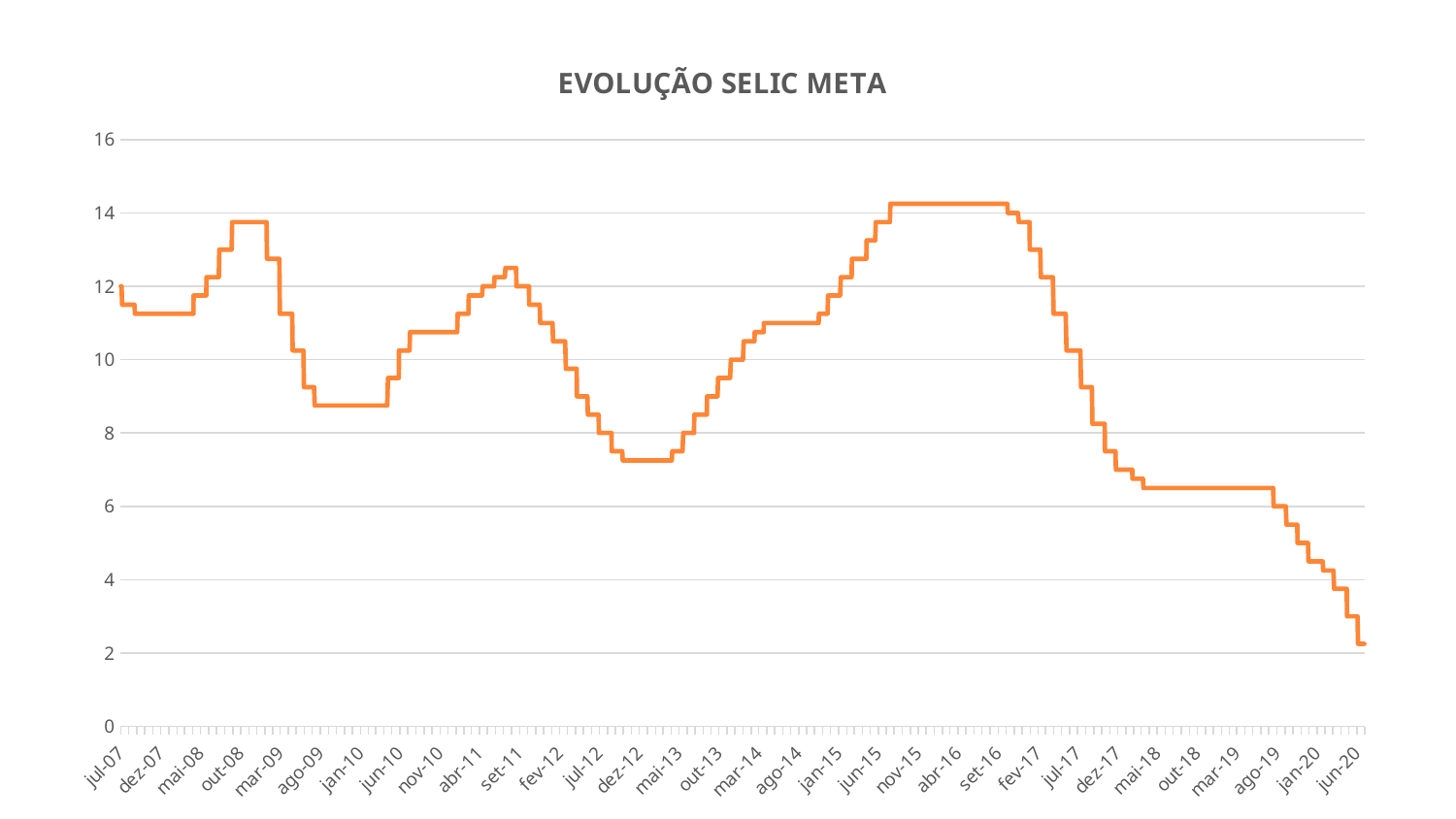
At which x-axis label does the line reach its lowest value? jun-20 Is the value for nov-15 greater or less than 12? greater Does the line rise or fall between set-16 and jun-20? Fall Is the value for jan-10 greater or less than 10? less Is the value for mar-18 greater or less than 8? less What is the title of the chart? EVOLUÇÃO SELIC META Which is larger, the value at out-08 or the value at jan-10? out-08 What kind of chart is shown on the slide? Line chart What colour is the line in the chart? Orange